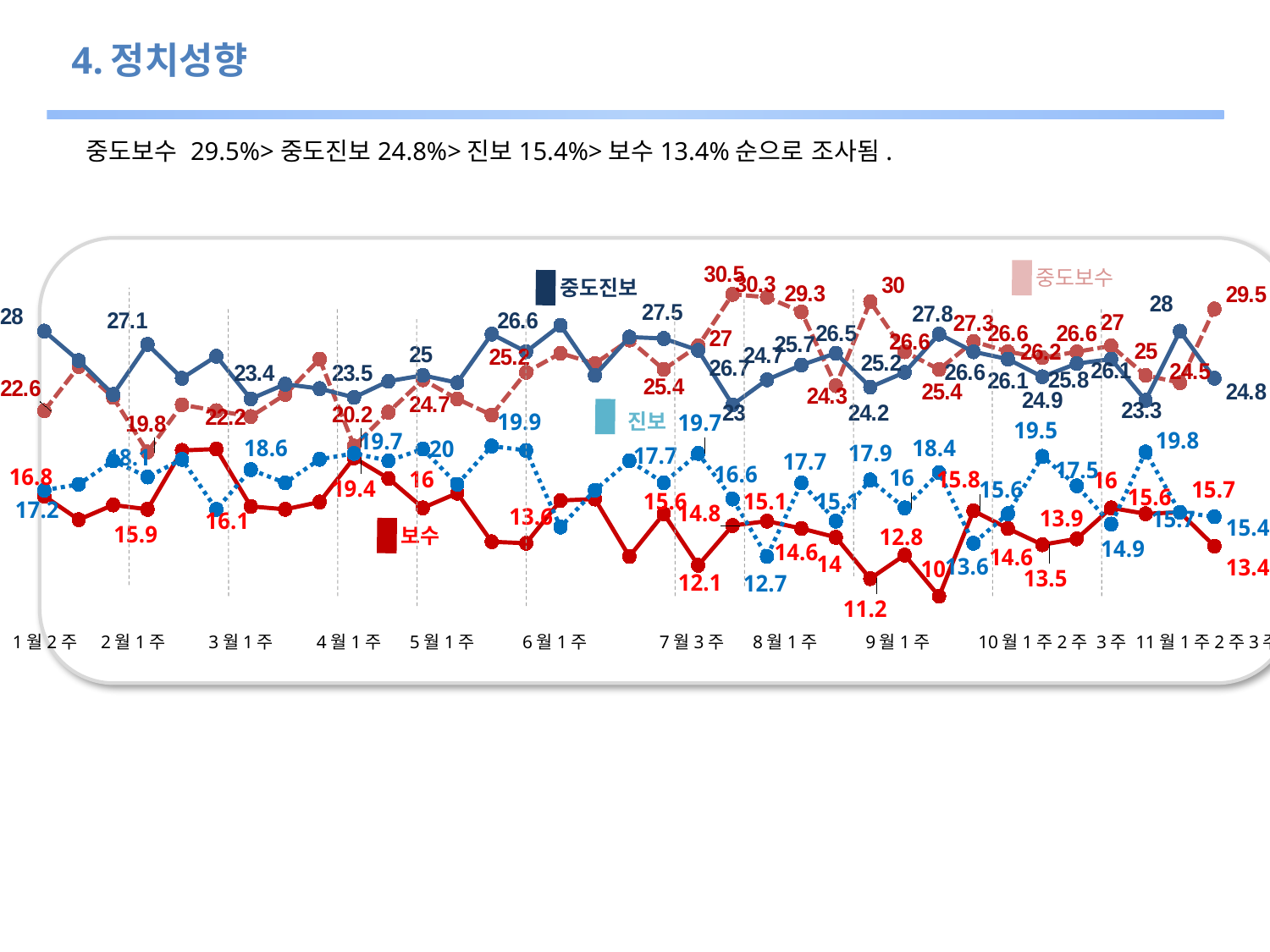
How many series are plotted on the chart? 4 What is the value of 보수 at 1월 2주? 16.8 What type of chart is shown on the slide? line chart What is the lowest value labeled on the 보수 line? 10 Does the 보수 line end higher or lower than it starts? lower What is the value of 진보 at the last point (11월 3주)? 15.4 At 11월 3주, what is the difference between 중도보수 (29.5) and 중도진보 (24.8)? 4.7 What colour is the 보수 series in the legend? red What is the value of 중도보수 at the last point (11월 3주)? 29.5 At 1월 2주, which is larger: 중도진보 or 중도보수? 중도진보 What is the highest value labeled on the 중도보수 line? 30.5 What is the value of 중도진보 at 2월 1주? 27.1